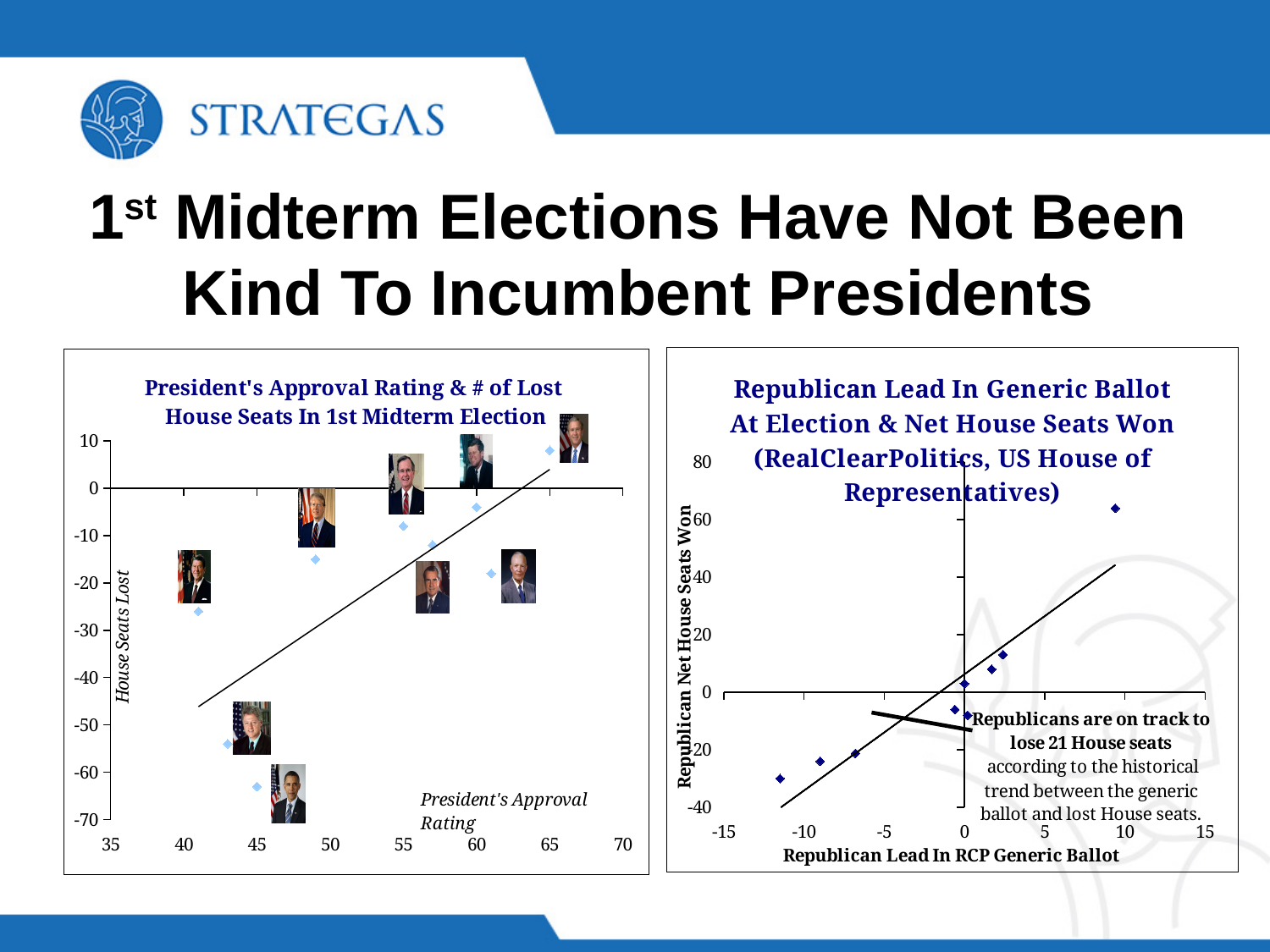
According to the annotation on the right chart, how many House seats are Republicans on track to lose? 21 What is the y-axis label of the left chart? House Seats Lost On the right chart, is the highest plotted point greater or less than 60 net House seats won? greater On the left chart, is the point with the highest approval rating (around 65) greater or less than 0 House seats lost? greater On the left chart, is the lowest plotted point greater or less than -60 House seats lost? less On the left chart, how many data points are plotted? 9 On the right chart, do Republican net House seats won rise or fall as the Republican lead in the generic ballot increases along the x axis? Rise What kind of chart is the right chart, 'Republican Lead In Generic Ballot At Election & Net House Seats Won'? Scatter chart What kind of chart is the left chart, 'President's Approval Rating & # of Lost House Seats In 1st Midterm Election'? Scatter chart On the left chart, do House seats lost generally rise or fall as the president's approval rating increases along the x axis? Rise What is the x-axis label of the right chart? Republican Lead In RCP Generic Ballot